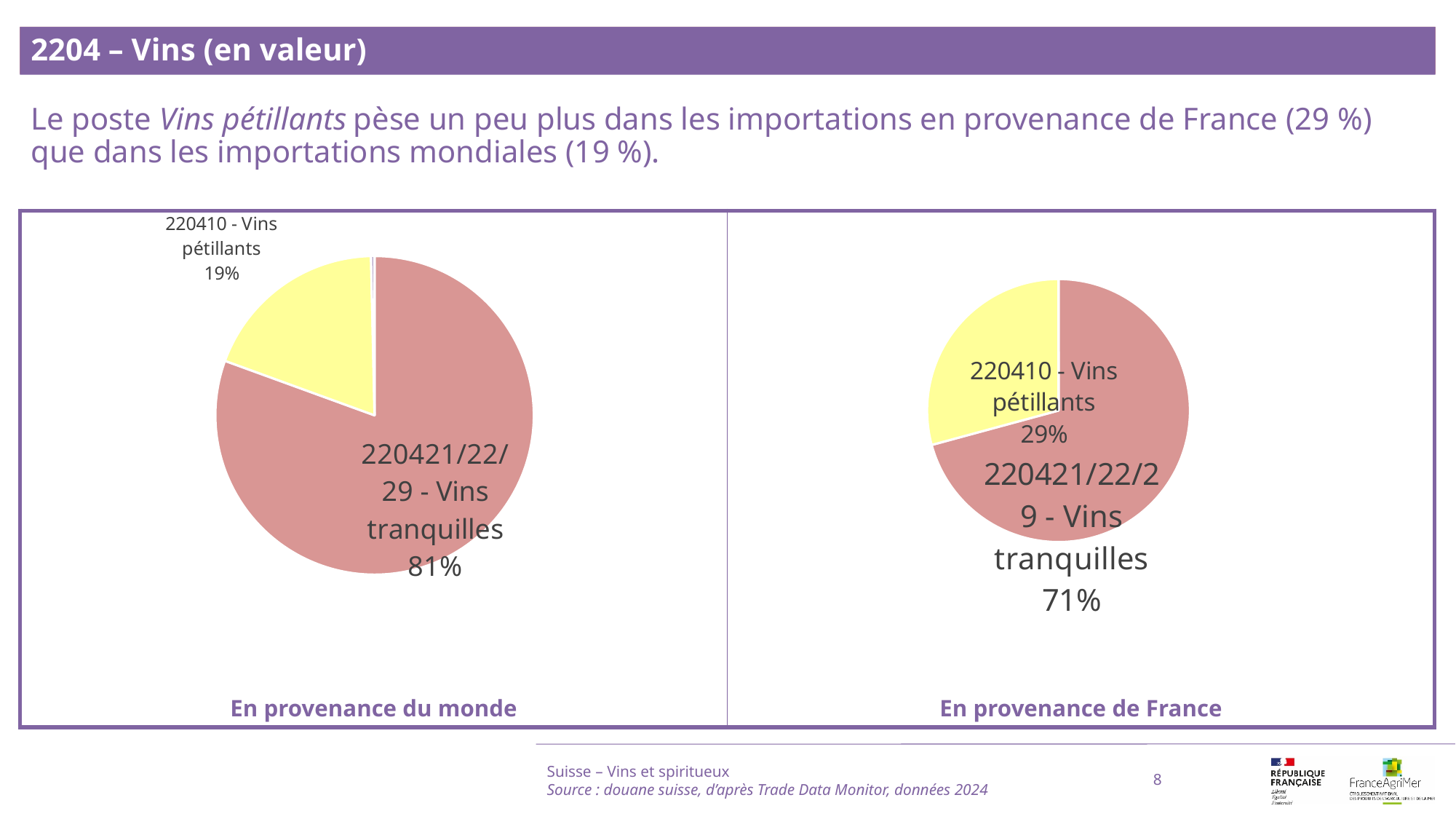
What is the difference in percentage points between the Vins pétillants share in the 'En provenance de France' chart and in the 'En provenance du monde' chart? 10 percentage points Is the share of Vins pétillants larger in the 'En provenance du monde' chart or in the 'En provenance de France' chart? En provenance de France In the 'En provenance de France' chart, what share is shown for 220410 - Vins pétillants? 29% In the 'En provenance de France' chart, which category has the largest slice? 220421/22/29 - Vins tranquilles In the 'En provenance du monde' chart, what share is shown for 220410 - Vins pétillants? 19% What colour is the Vins pétillants slice in the 'En provenance du monde' chart? Yellow In the 'En provenance de France' chart, what is the difference in percentage points between Vins tranquilles and Vins pétillants? 42 percentage points In the 'En provenance du monde' chart, what share is shown for 220421/22/29 - Vins tranquilles? 81% What kind of chart is used in the 'En provenance du monde' panel? Pie chart How many labelled slices does the 'En provenance de France' pie chart have? 2 In the 'En provenance du monde' chart, which labelled category has the smallest slice? 220410 - Vins pétillants